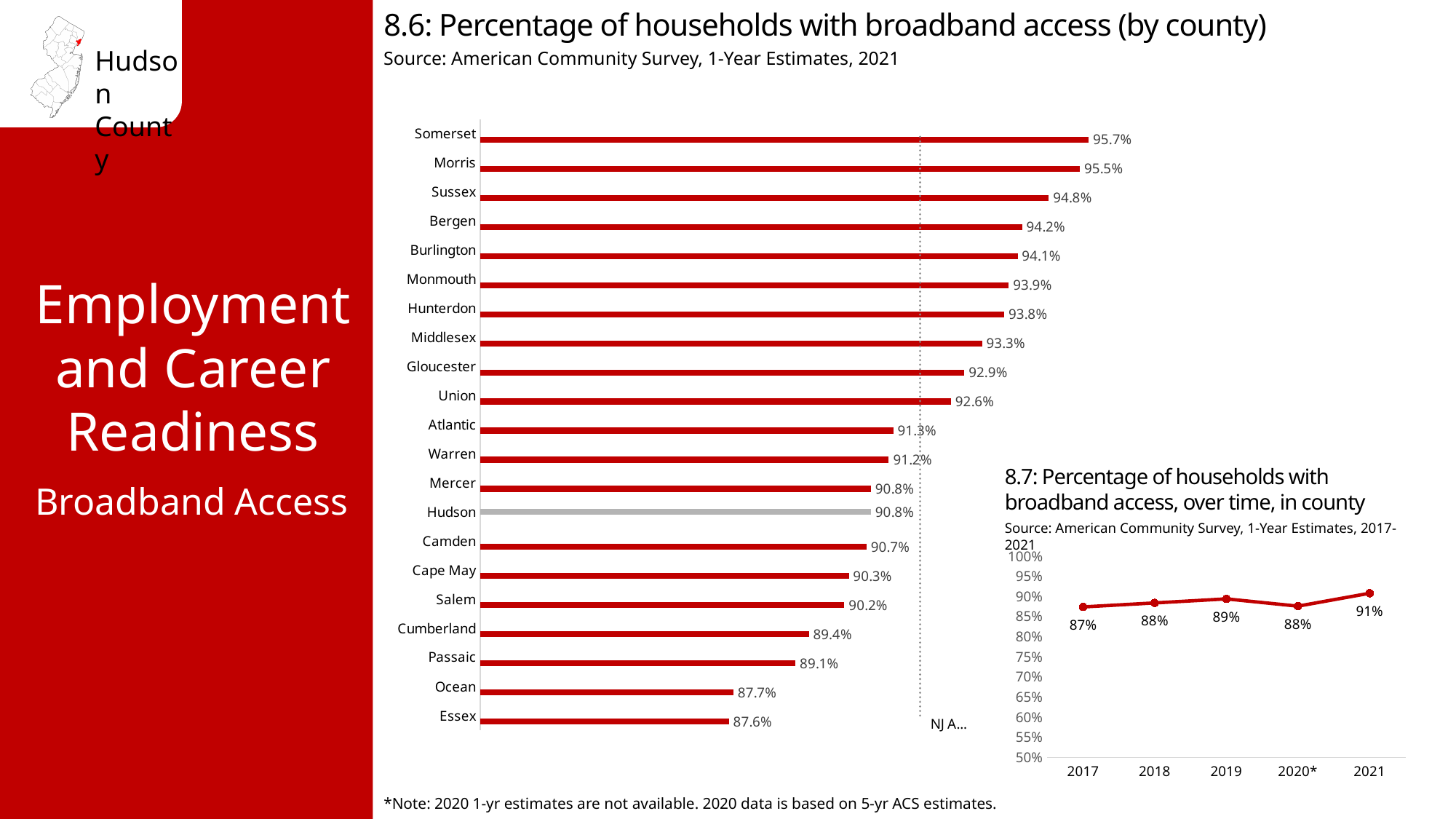
In chart 8.7 (over time, in county), what is the value for 2021? 91% In chart 8.6 (Percentage of households with broadband access by county), what is the value for Hudson? 90.8% In chart 8.6 (by county), what is the difference between Somerset and Essex? 8.1 percentage points In chart 8.6 (by county), which county has the lowest percentage of households with broadband access? Essex In chart 8.6 (by county), how many counties are shown? 21 In chart 8.6 (by county), what is the value for Bergen? 94.2% In chart 8.6 (by county), which is larger, the value for Passaic or the value for Cumberland? Cumberland What kind of chart is chart 8.7 (over time, in county)? Line chart What kind of chart is chart 8.6 (by county)? Bar chart In chart 8.6 (by county), which county has the highest percentage of households with broadband access? Somerset In chart 8.7 (over time, in county), what is the value for 2017? 87% In chart 8.7 (over time, in county), what is the difference between 2021 and 2017? 4 percentage points